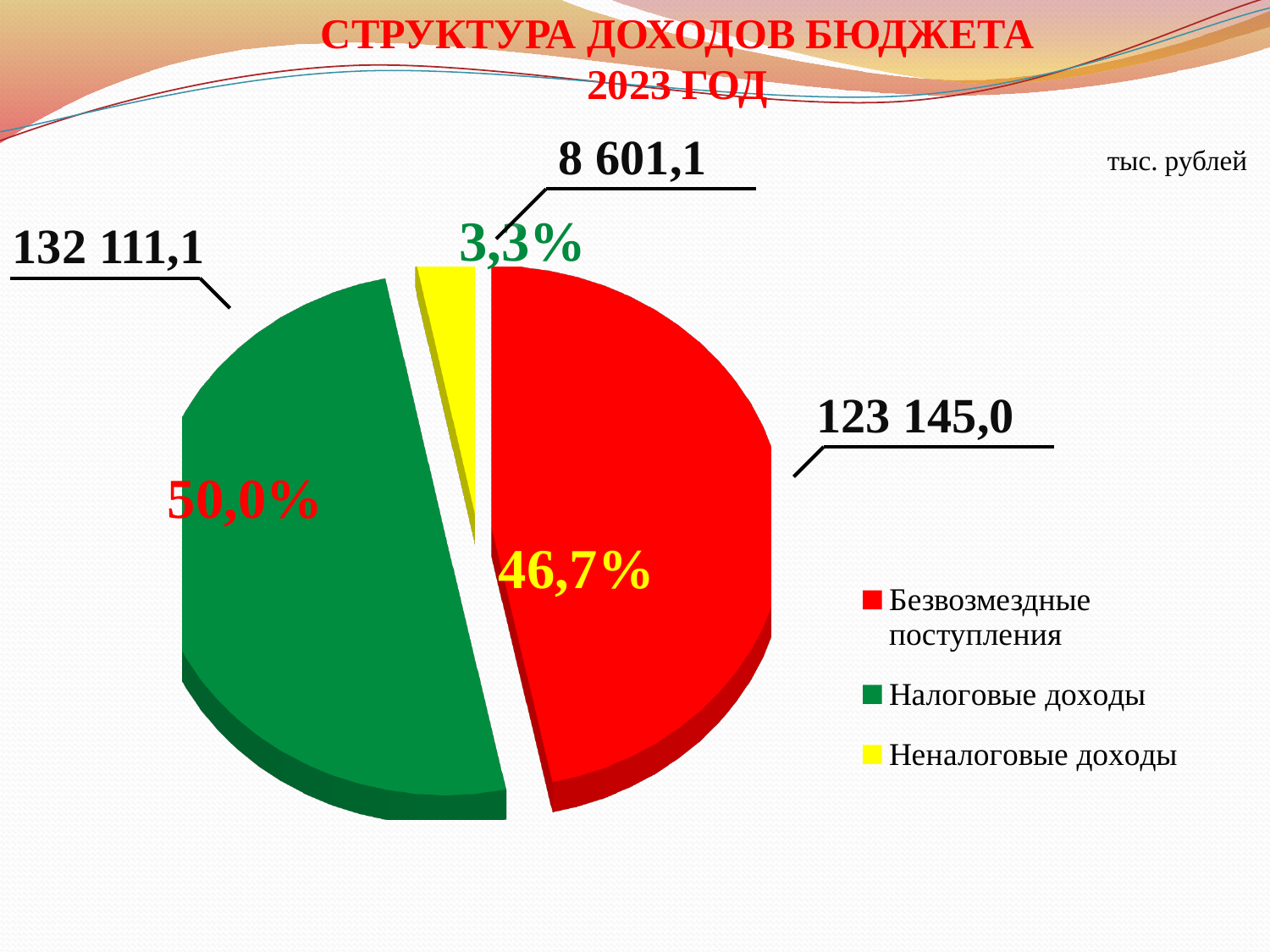
What share of the pie does Налоговые доходы represent? 50,0% Which colour represents Неналоговые доходы in the legend? Yellow How many slices does the pie chart have? 3 What kind of chart is shown on the slide? Pie chart Which category has the largest slice? Налоговые доходы How many entries does the legend list? 3 What is the value for Неналоговые доходы? 8 601,1 What share of the pie does Неналоговые доходы represent? 3,3% What is the value for Налоговые доходы? 132 111,1 What share of the pie does Безвозмездные поступления represent? 46,7% What is the value for Безвозмездные поступления? 123 145,0 Which category has the smallest slice? Неналоговые доходы